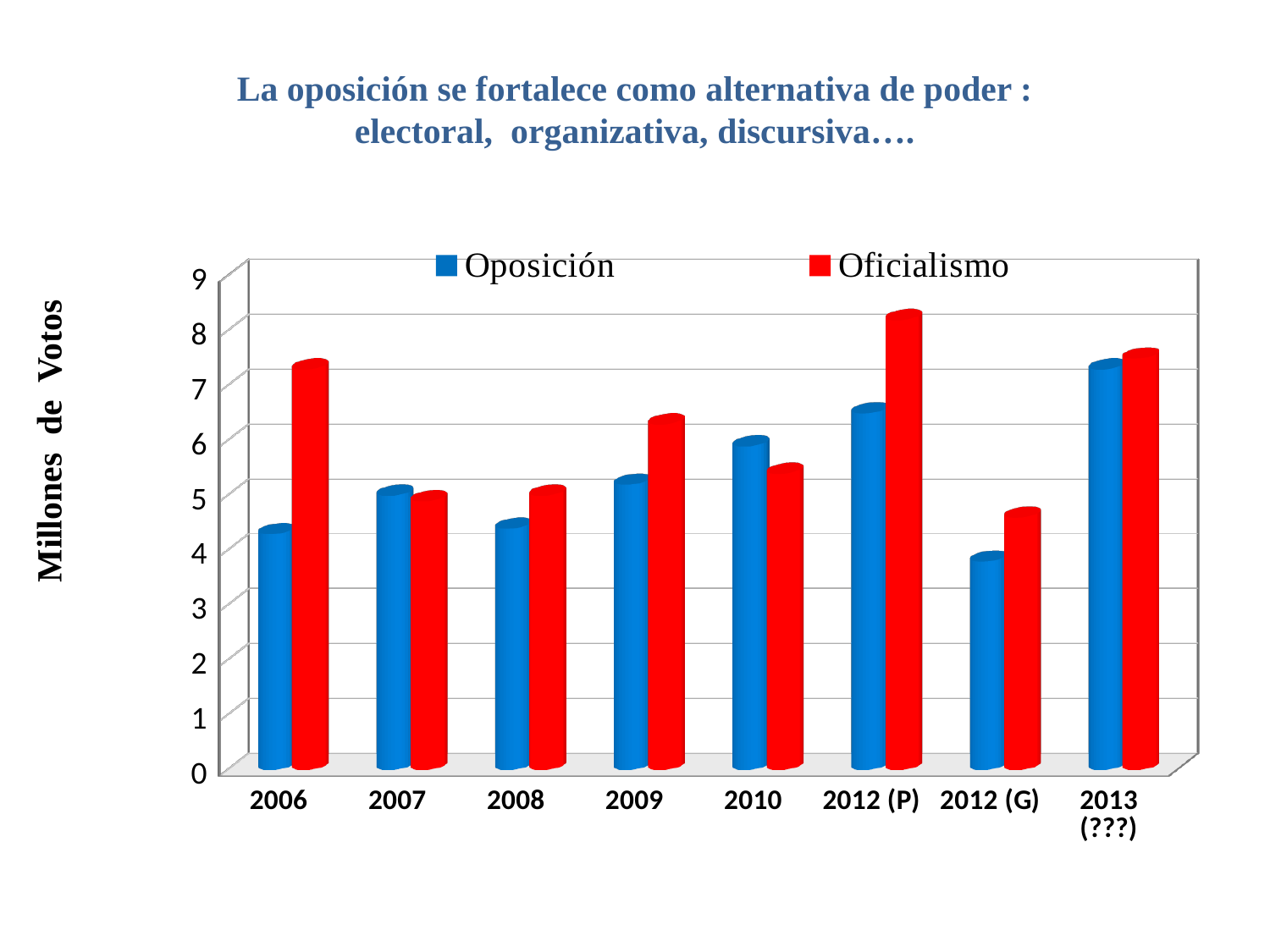
Is the Oposición value for 2012 (G) greater or less than 4? less In 2006, which series has the larger value, Oposición or Oficialismo? Oficialismo How many categories are shown on the x axis? 8 In which category is the Oposición value lowest? 2012 (G) How many series does the legend list? 2 In which category is the Oficialismo value highest? 2012 (P) What is the label of the vertical axis? Millones de Votos Is the Oficialismo value for 2012 (P) greater or less than 8? greater Which colour represents the Oficialismo series? red In 2010, which series has the larger value, Oposición or Oficialismo? Oposición Is the Oficialismo value for 2006 greater or less than 7? greater What kind of chart is shown on the slide? bar chart